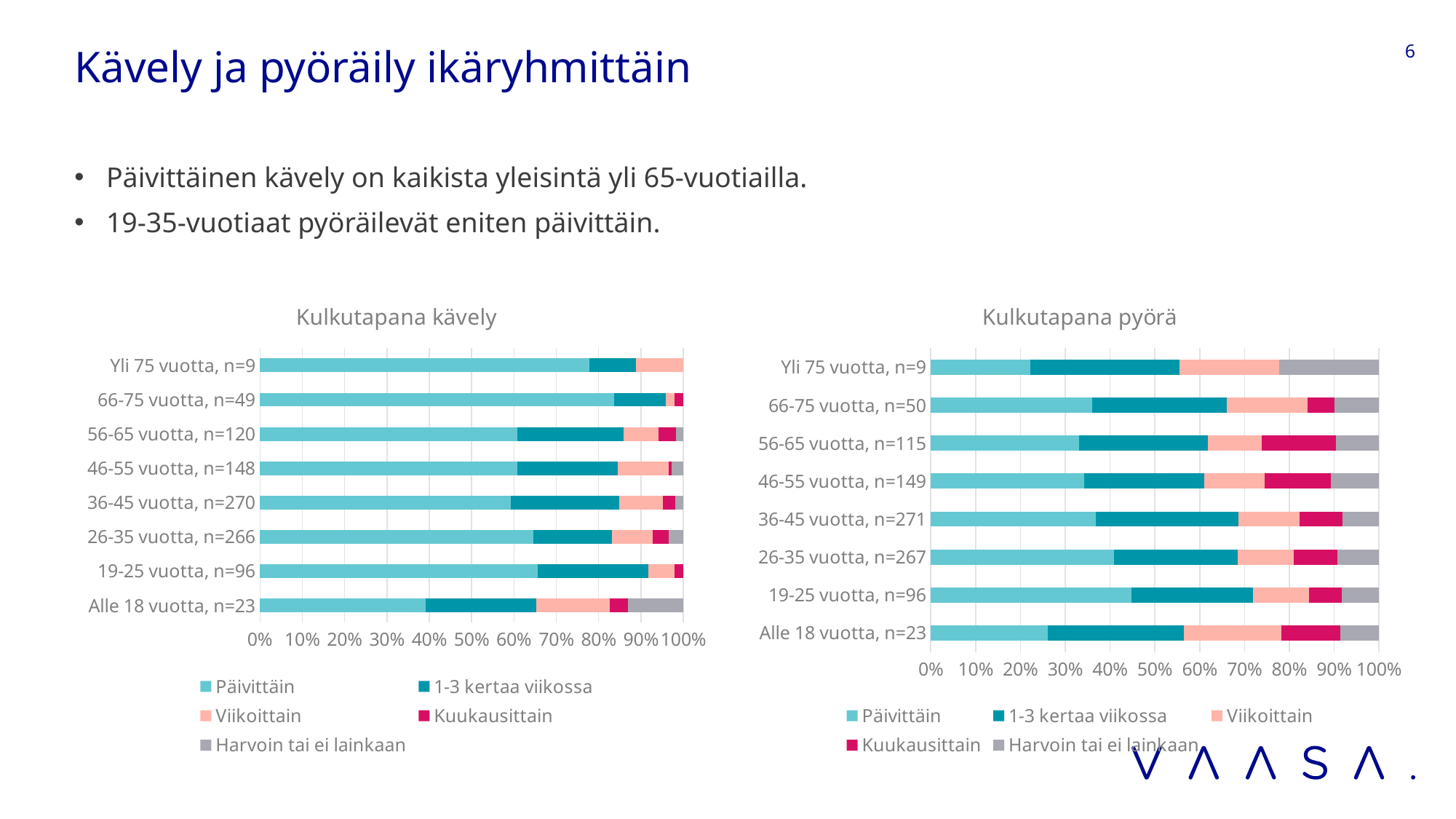
What kind of chart is "Kulkutapana kävely"? Stacked bar chart In the "Kulkutapana pyörä" chart, which age group has the largest Päivittäin share? 19-25 vuotta, n=96 What is the title of the chart on the right side of the slide? Kulkutapana pyörä In the "Kulkutapana pyörä" chart, is the Päivittäin share for 19-25 vuotta greater or less than 40%? greater In the "Kulkutapana kävely" chart, which age group has the smallest Päivittäin share? Alle 18 vuotta, n=23 In the "Kulkutapana kävely" chart, which has the larger Päivittäin share: Alle 18 vuotta or 19-25 vuotta? 19-25 vuotta, n=96 In the "Kulkutapana kävely" chart, which age group has the largest Päivittäin share? 66-75 vuotta, n=49 In the "Kulkutapana pyörä" chart, is the Päivittäin share for Yli 75 vuotta greater or less than 30%? less How many age groups are shown in the "Kulkutapana pyörä" chart? 8 In the "Kulkutapana pyörä" chart, which age group has the smallest Päivittäin share? Yli 75 vuotta, n=9 How many series does the legend of the "Kulkutapana kävely" chart list? 5 In the "Kulkutapana kävely" chart, is the Päivittäin share for Yli 75 vuotta greater or less than 70%? greater